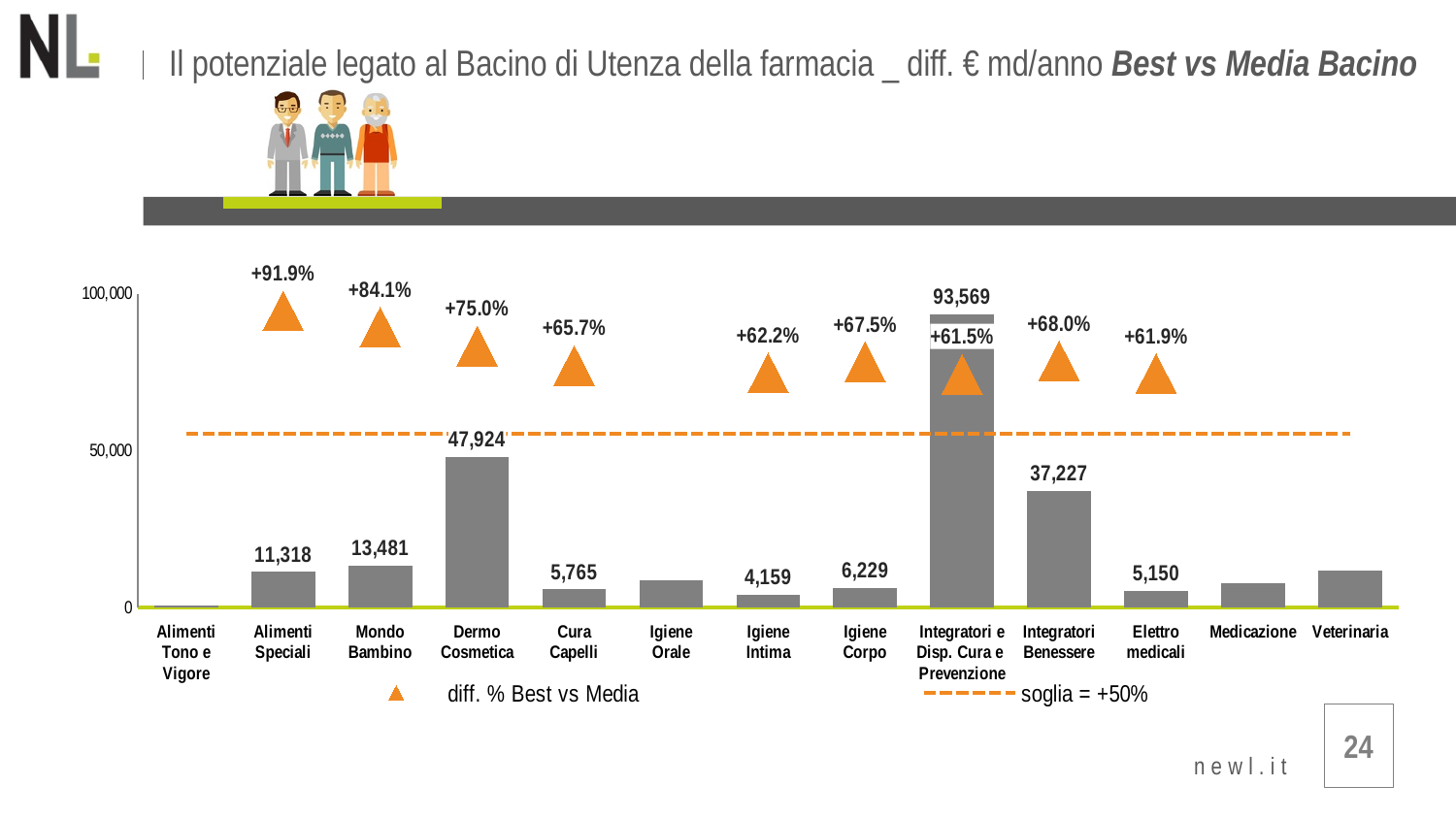
Which category has the highest diff. % Best vs Media? Alimenti Speciali Is the value for Igiene Orale greater or less than 50,000? less What is the diff. % Best vs Media shown for Alimenti Speciali? +91.9% How many categories are shown on the x axis? 13 What does the legend say the dashed horizontal line represents? soglia = +50% What is the difference between the values for Mondo Bambino and Alimenti Speciali? 2,163 What is the value shown for Integratori Benessere? 37,227 Which is larger, the value for Cura Capelli or the value for Igiene Corpo? Igiene Corpo What kind of chart is shown on the slide? combination bar and line chart What is the difference between the values for Integratori e Disp. Cura e Prevenzione and Dermo Cosmetica? 45,645 What is the value shown for Dermo Cosmetica? 47,924 Which category has the highest bar? Integratori e Disp. Cura e Prevenzione